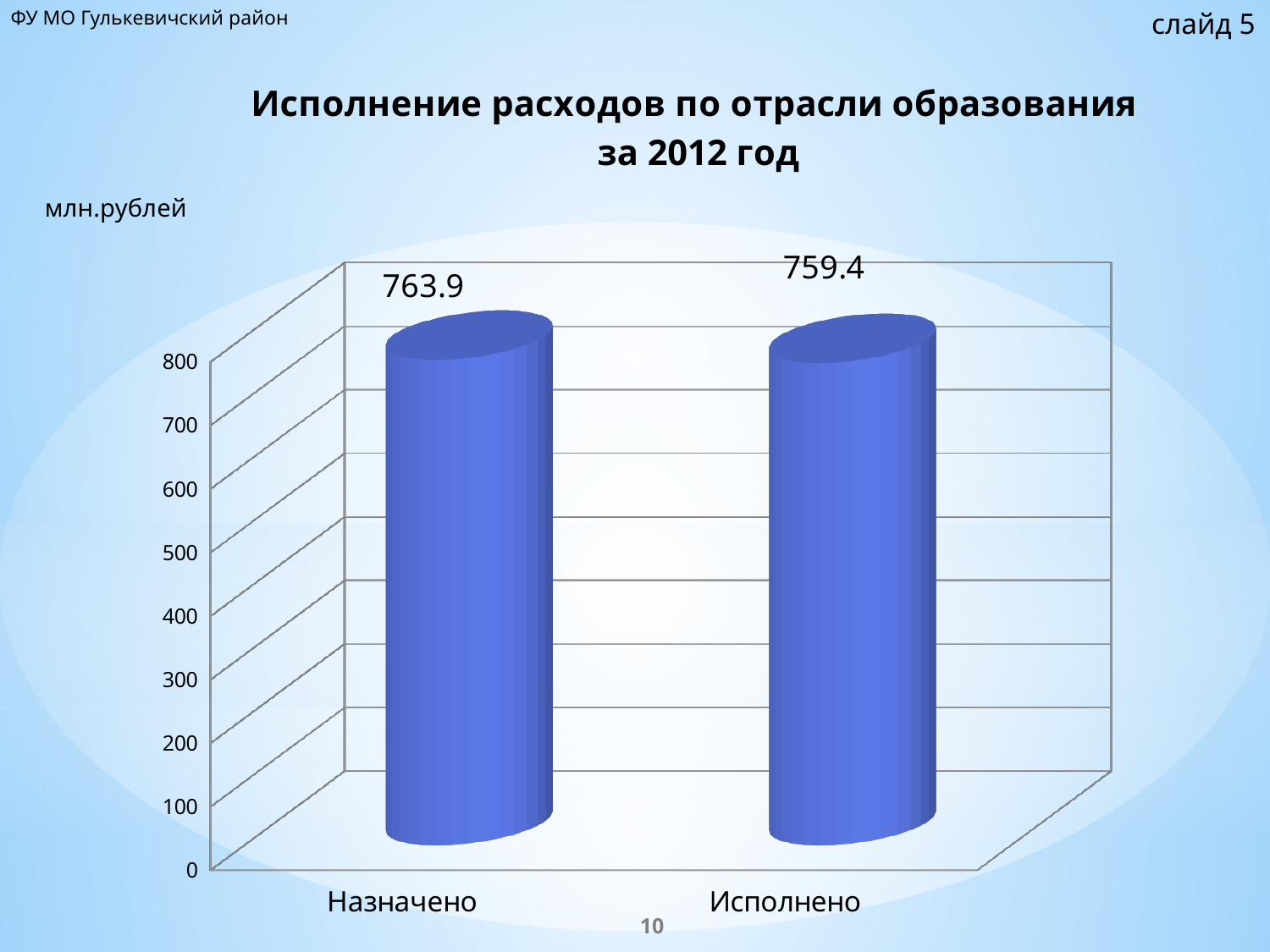
How many categories are shown on the x axis? 2 Is the value for Назначено greater or less than 800? less What is the value for Назначено? 763.9 Is the value for Исполнено greater or less than 700? greater Which category has the higher value, Назначено or Исполнено? Назначено What is the highest tick value shown on the vertical axis? 800 What kind of chart is shown on the slide? bar chart What is the value for Исполнено? 759.4 What is the title of the chart? Исполнение расходов по отрасли образования за 2012 год What is the difference between the values for Назначено and Исполнено? 4.5 What unit is indicated for the values on the chart? млн.рублей